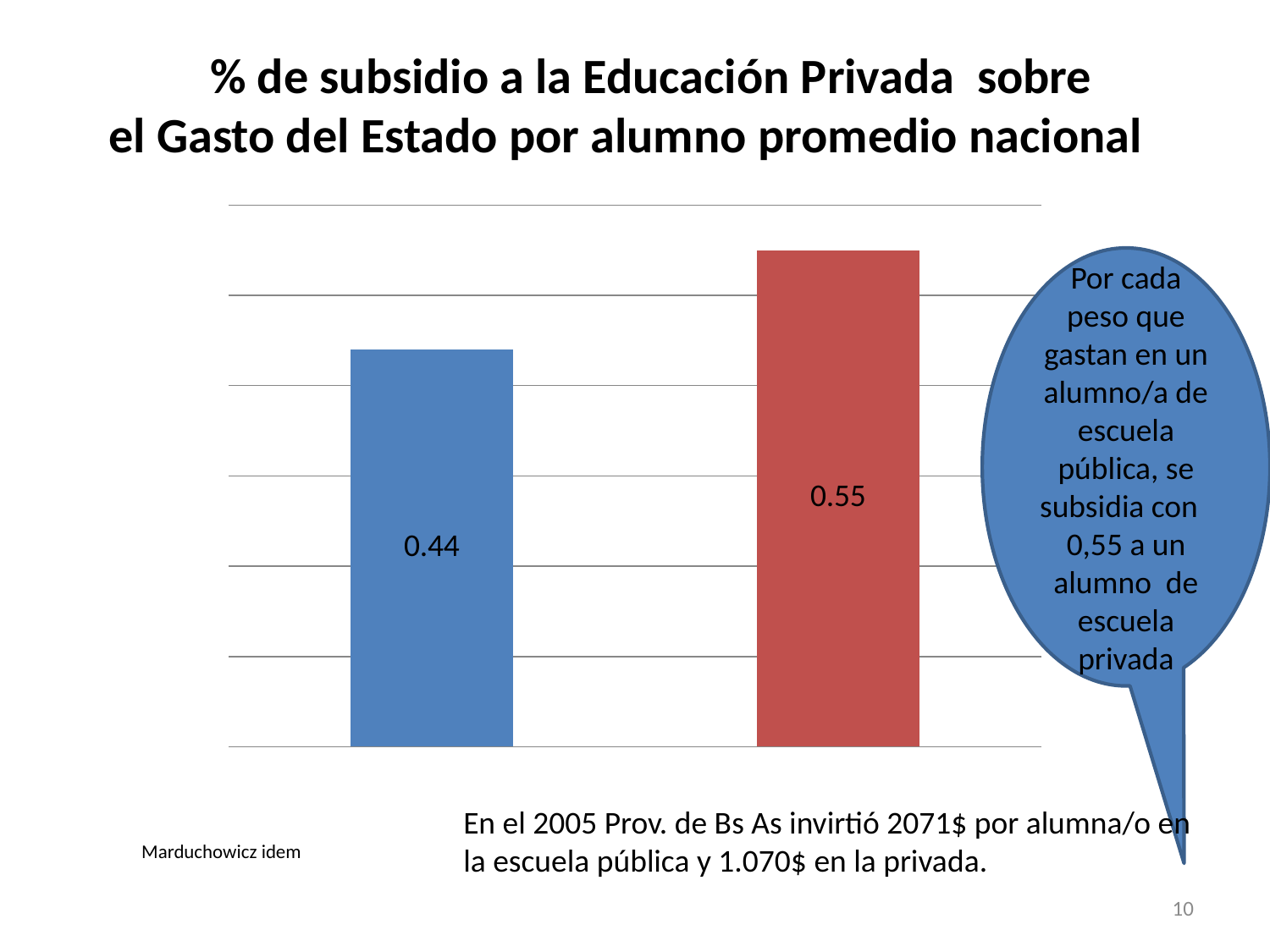
How many bars are plotted in the chart? 2 What is the value shown on the red bar? 0.55 Which bar has the lower value, the left one or the right one? the left one What is the value shown on the blue bar? 0.44 What is the title of the chart? % de subsidio a la Educación Privada sobre el Gasto del Estado por alumno promedio nacional What colour is the bar with the value 0.55? red Which bar has the higher value, the blue one or the red one? the red one Is the value of the left bar larger or smaller than the value of the right bar? smaller What kind of chart is shown on the slide? bar chart What is the difference between the red bar's value and the blue bar's value? 0.11